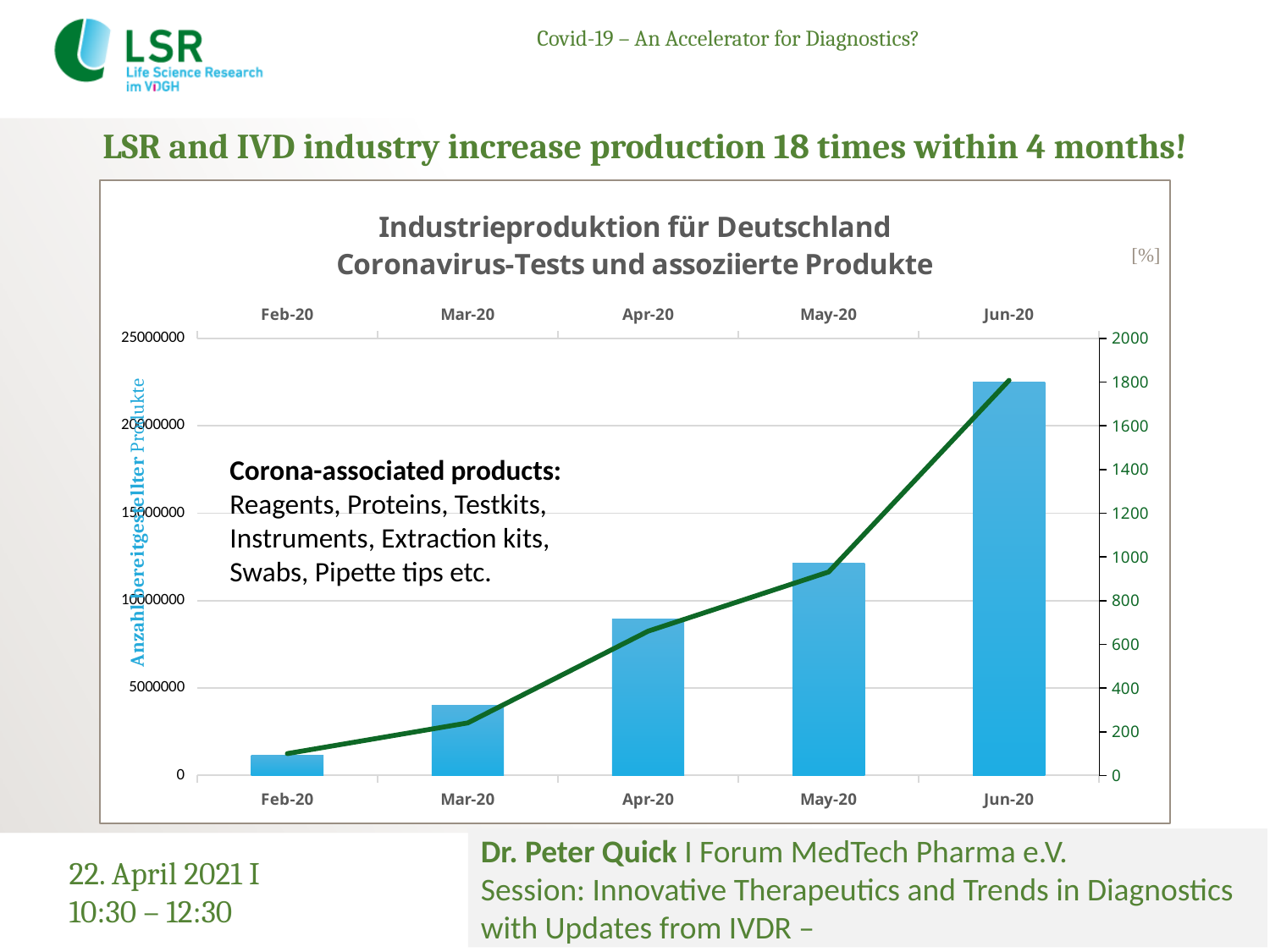
Is the bar value for Jun-20 greater or less than 20000000? greater Which month has the larger bar, Mar-20 or Apr-20? Apr-20 Is the bar value for Apr-20 greater or less than 10000000? less Is the bar value for Feb-20 greater or less than 5000000? less What kind of chart is shown on the slide? A combined bar and line chart What is the title of the chart? Industrieproduktion für Deutschland Coronavirus-Tests und assoziierte Produkte Do the bar values rise or fall from Feb-20 to Jun-20? Rise Which month has the shortest bar in the chart? Feb-20 Which month has the tallest bar in the chart? Jun-20 How many months are shown on the x axis of the chart? 5